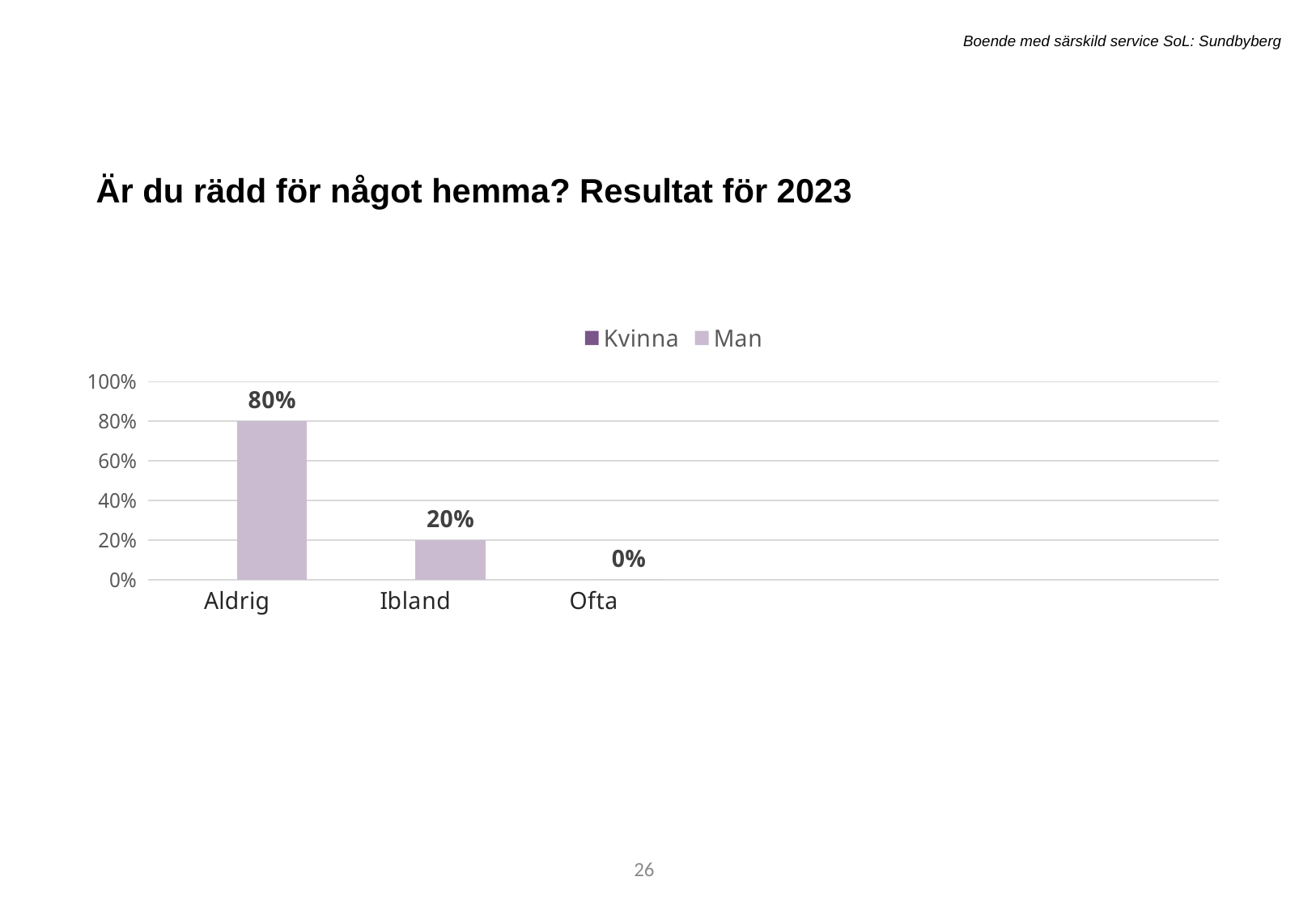
How many series does the legend list? 2 What are the two series named in the legend? Kvinna and Man Which category has the highest value for Man? Aldrig Which category has the lowest value for Man? Ofta Do the Man values rise or fall from Aldrig to Ofta along the x axis? fall What is the value for Man in the Ibland category? 20% What is the difference between the Man values for Aldrig and Ibland? 60% What is the value for Man in the Ofta category? 0% How many categories are shown on the x axis? 3 What kind of chart is shown on the slide? bar chart What is the value for Man in the Aldrig category? 80% Which is larger for Man: the value for Aldrig or the value for Ibland? Aldrig